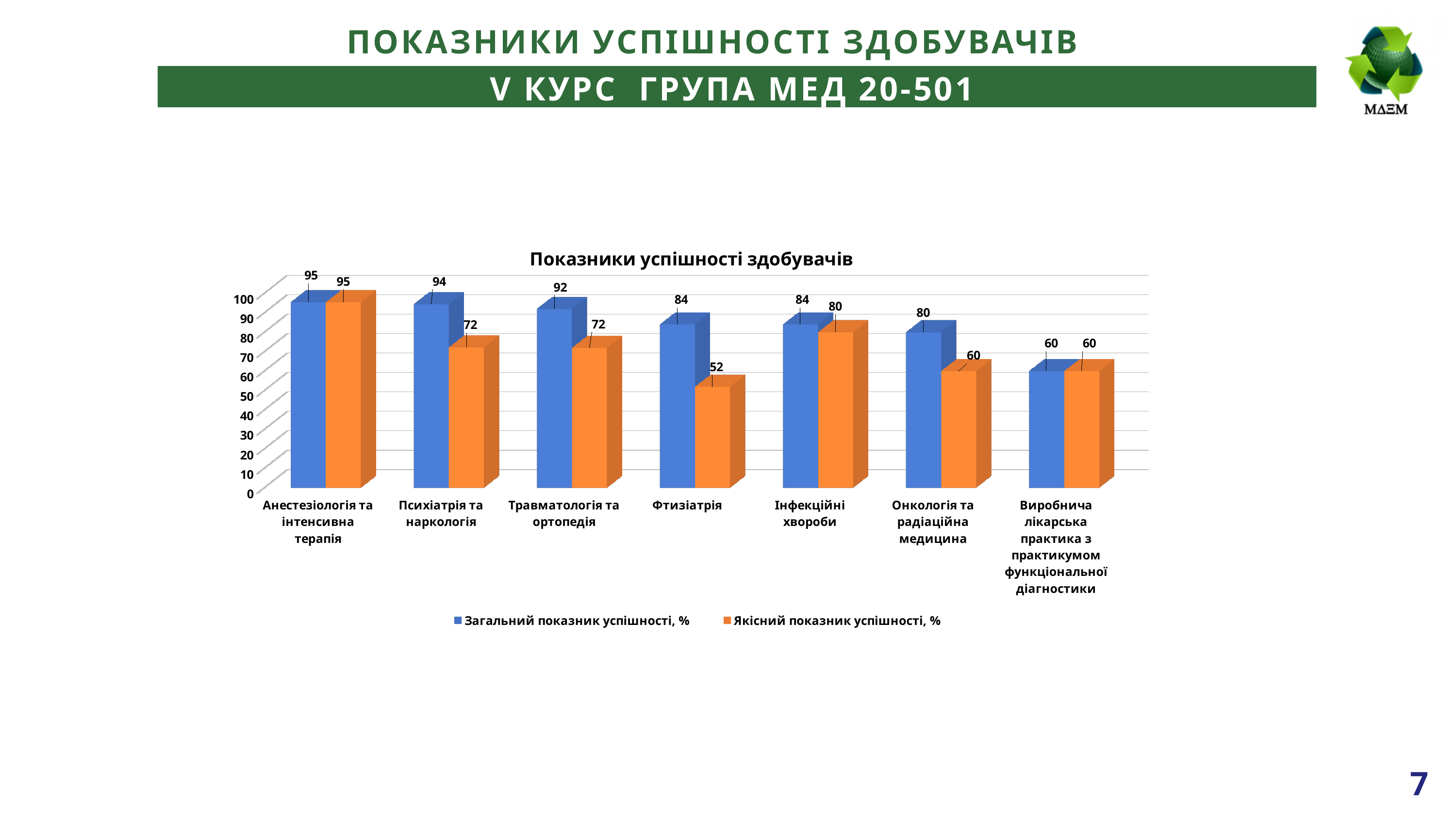
What is the value of Якісний показник успішності, % for Онкологія та радіаційна медицина? 60 What is the difference between the Загальний показник успішності, % and the Якісний показник успішності, % for Фтизіатрія? 32 Which category has the highest Загальний показник успішності, %? Анестезіологія та інтенсивна терапія Which category has the lowest Якісний показник успішності, %? Фтизіатрія What kind of chart is shown on the slide? Bar chart How many series does the legend list? 2 Which is larger: the Якісний показник успішності, % for Інфекційні хвороби or for Травматологія та ортопедія? Інфекційні хвороби How many categories are shown on the x axis of the chart? 7 What is the value of Загальний показник успішності, % for Фтизіатрія? 84 What is the difference between the Загальний показник успішності, % for Травматологія та ортопедія and for Інфекційні хвороби? 8 What is the value of Якісний показник успішності, % for Психіатрія та наркологія? 72 What is the title of the chart? Показники успішності здобувачів